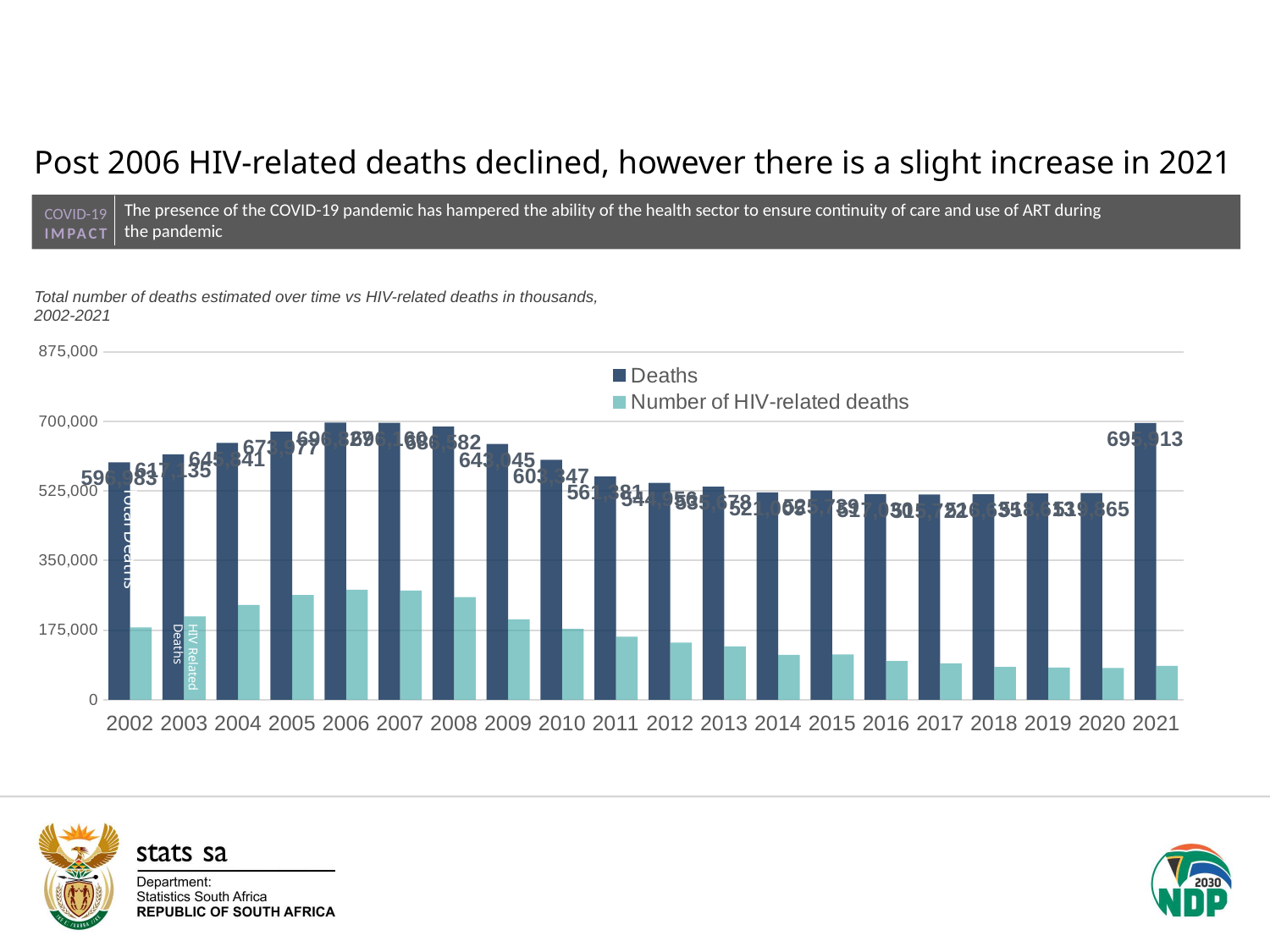
How many series does the legend list? 2 What kind of chart is shown on the slide? bar chart What is the difference between Deaths in 2005 and Deaths in 2002? 76,994 Which is larger: Deaths in 2003 or Deaths in 2004? 2004 What are the two entries in the chart legend? Deaths; Number of HIV-related deaths What is the value of Deaths for 2011? 561,381 How many years are shown on the x axis? 20 Do the Number of HIV-related deaths values rise or fall from 2007 to 2020? fall Is the value for Number of HIV-related deaths in 2021 greater or less than 175,000? less What is the value of Deaths for 2002? 596,983 What is the value of Deaths for 2005? 673,977 What is the value of Deaths for 2021? 695,913